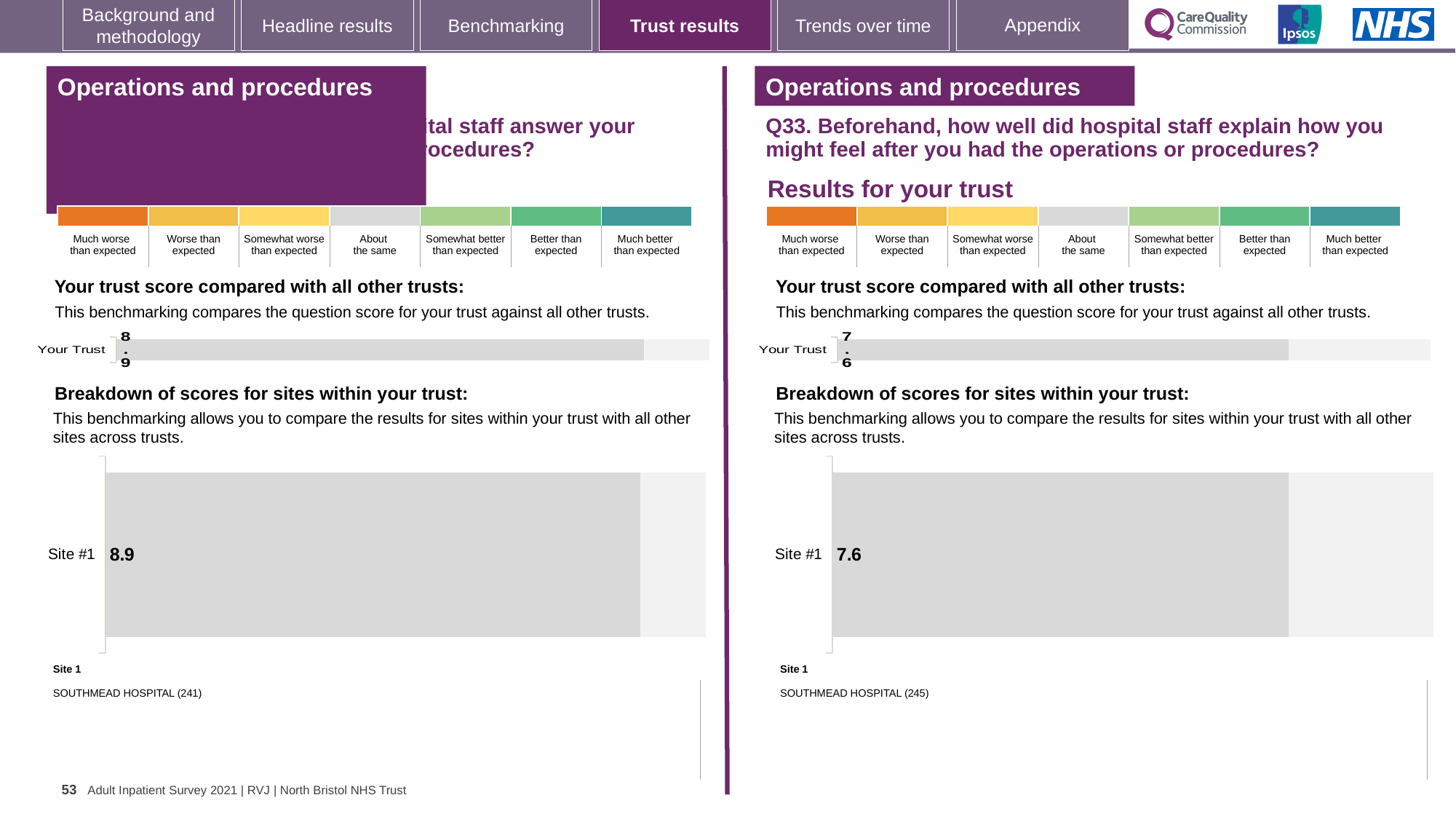
On the right-hand panel (Q33), is the Your Trust score the same as the Site #1 score? Yes, both are 7.6 On the left-hand panel, which site name is listed under Site 1 below the breakdown chart? SOUTHMEAD HOSPITAL (241) How many sites are shown in the 'Breakdown of scores for sites within your trust' chart on the right-hand panel (Q33)? 1 What kind of chart is used to show the Site #1 score on the left-hand panel? Bar chart Which is larger: the Site #1 score on the left-hand panel or the Site #1 score on the right-hand panel (Q33)? Left-hand panel (8.9) On the left-hand panel, what is the score shown for Your Trust in the 'Your trust score compared with all other trusts' chart? 8.9 On the right-hand panel (Q33), what score is shown for Site #1 in the 'Breakdown of scores for sites within your trust' chart? 7.6 What is the difference between the Site #1 score on the left-hand panel and the Site #1 score on the right-hand panel (Q33)? 1.3 On the right-hand panel (Q33), what is the score shown for Your Trust in the 'Your trust score compared with all other trusts' chart? 7.6 On the right-hand panel (Q33), which site name is listed under Site 1 below the breakdown chart? SOUTHMEAD HOSPITAL (245) On the left-hand panel, what score is shown for Site #1 in the 'Breakdown of scores for sites within your trust' chart? 8.9